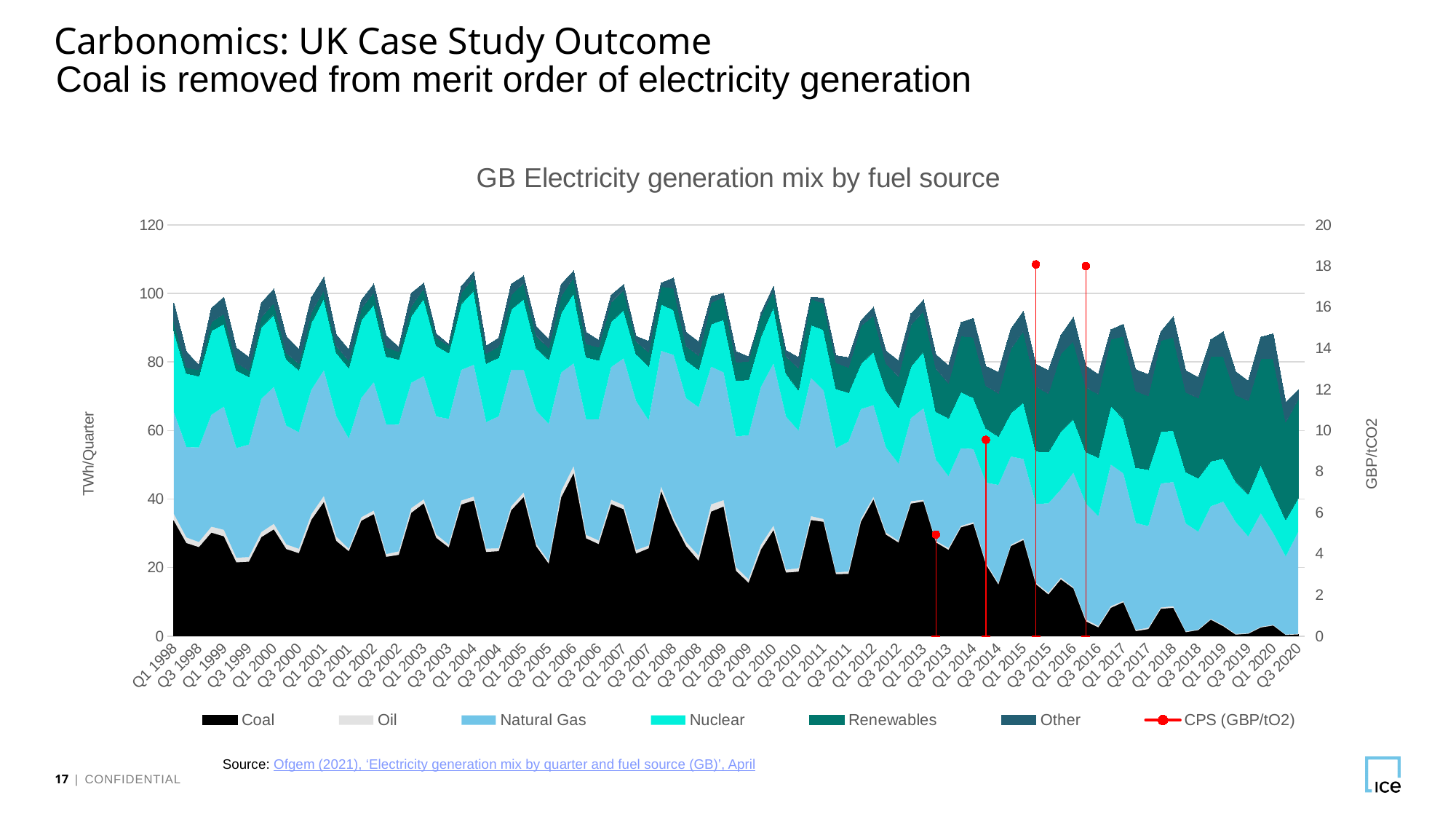
What is the title of the chart? GB Electricity generation mix by fuel source Does the Renewables series rise or fall over the period from 1998 to 2020? Rise How many CPS (GBP/tO2) data points are plotted on the chart? 4 Does the Coal series rise or fall over the period from 1998 to 2020? Fall Which is larger, the Coal value in Q1 2006 or the Coal value in Q1 2019? Q1 2006 Is the value for Coal in Q1 2006 greater or less than 40 TWh/Quarter? greater What is the label of the left vertical axis? TWh/Quarter What kind of chart is used to show the fuel source generation mix? Stacked area chart How many series does the chart legend list? 7 Is the value for Coal in Q3 2020 greater or less than 20 TWh/Quarter? less